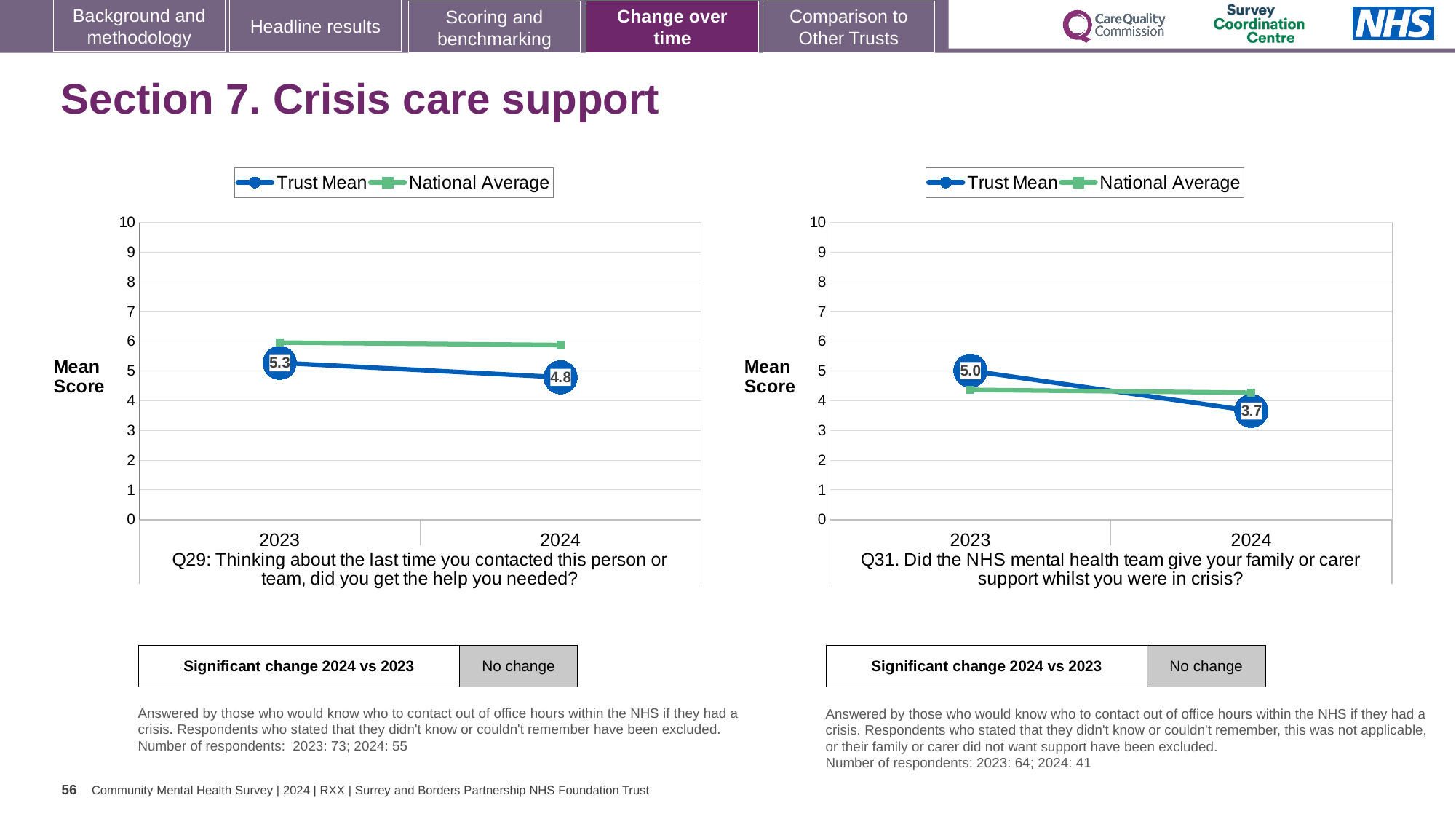
In the Q31 chart on the right, is the National Average for 2024 greater or less than 5? less In the Q31 chart on the right, does the Trust Mean rise or fall from 2023 to 2024? fall In the Q29 chart on the left, by how much did the Trust Mean fall from 2023 to 2024? 0.5 In the Q29 chart on the left, is the National Average for 2023 greater or less than 5? greater In the Q31 chart on the right, which is larger in 2023: the Trust Mean or the National Average? Trust Mean How many series does the legend of the Q29 chart on the left list? 2 In the Q31 chart on the right, what is the difference between the Trust Mean in 2023 and in 2024? 1.3 What kind of chart is used for Q31 on the right? line chart In the Q29 chart on the left, what is the Trust Mean score for 2024? 4.8 In the Q31 chart on the right, what is the Trust Mean score for 2024? 3.7 In the Q31 chart on the right, what is the Trust Mean score for 2023? 5.0 In the Q29 chart on the left, what is the Trust Mean score for 2023? 5.3